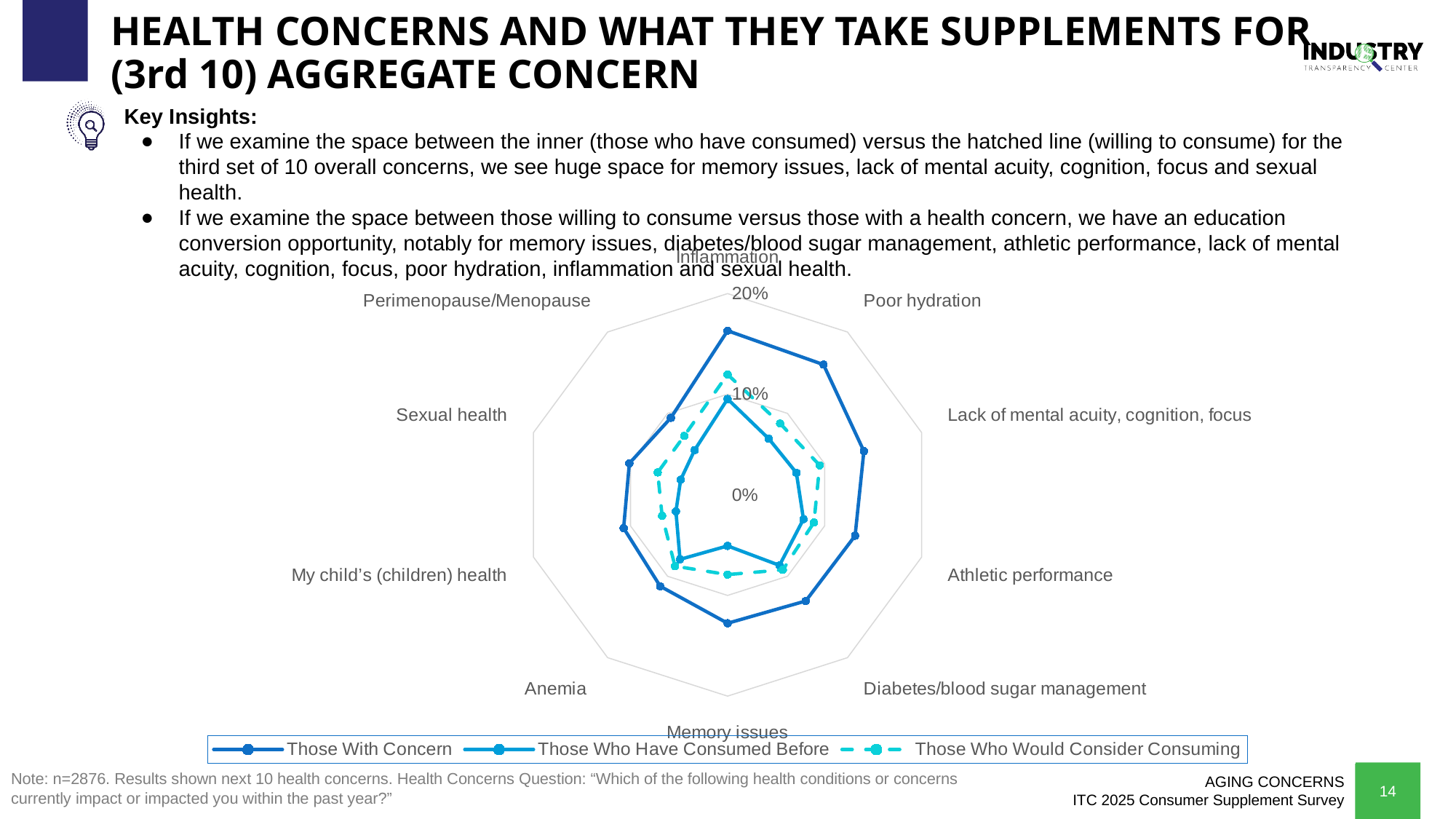
What kind of chart is shown on the slide? Radar chart How many series does the chart legend list? 3 Is the value for Memory issues in the Those Who Have Consumed Before series greater or less than 10%? less Is the value for Poor hydration in the Those With Concern series greater or less than 10%? greater Is the value for Inflammation in the Those With Concern series greater or less than 10%? greater For Memory issues, which series has the larger value: Those Who Would Consider Consuming or Those Who Have Consumed Before? Those Who Would Consider Consuming Which series is drawn with a dashed line in the chart? Those Who Would Consider Consuming What is the highest percentage label shown on the chart's axis? 20% How many health concern categories are plotted on the radar chart? 10 For Inflammation, which series has the larger value: Those With Concern or Those Who Have Consumed Before? Those With Concern For Lack of mental acuity, cognition, focus, which series has the larger value: Those With Concern or Those Who Would Consider Consuming? Those With Concern